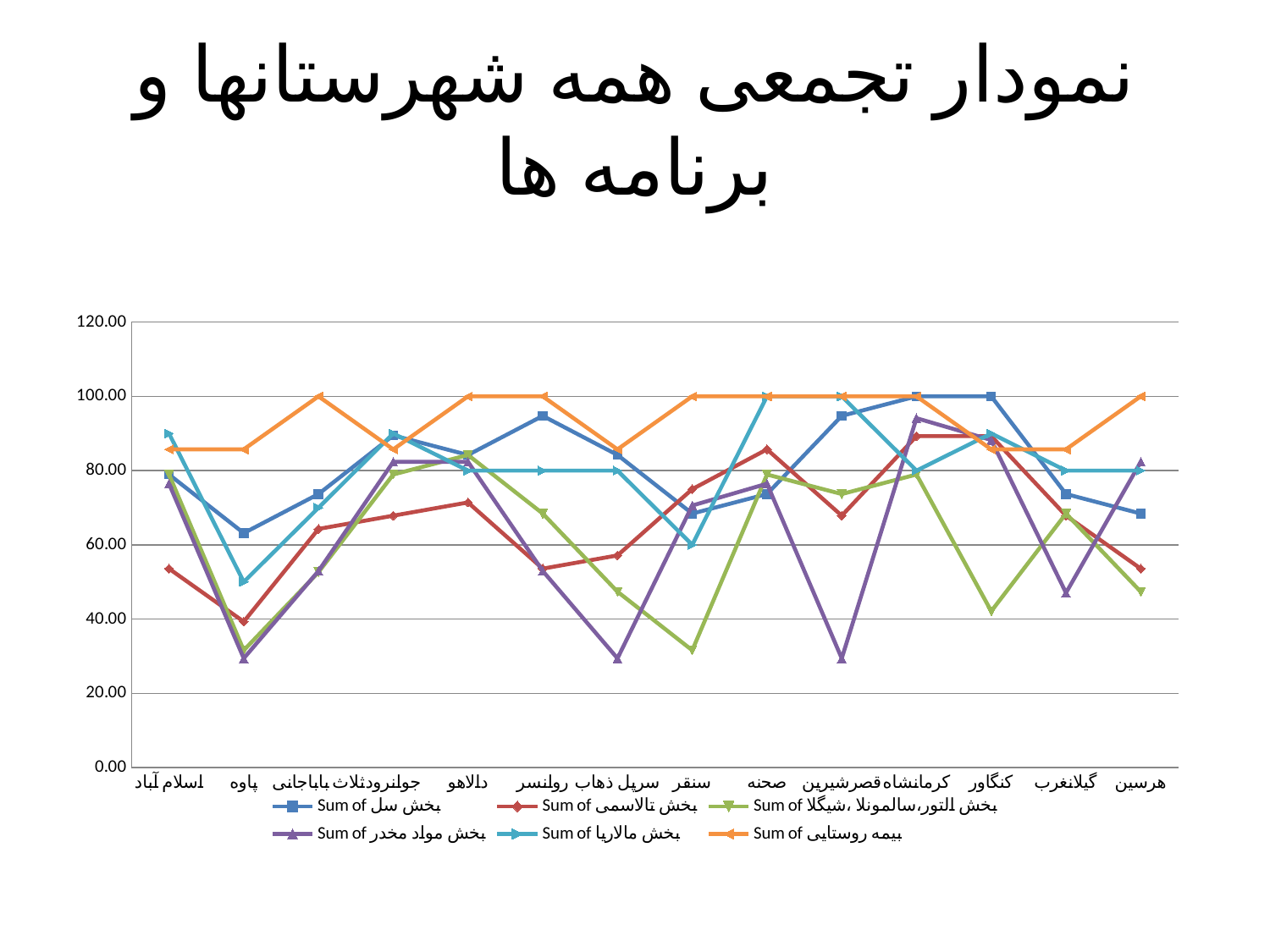
Which series has the highest value for هرسین? Sum of بیمه روستایی Is the value of Sum of بخش سل for روانسر greater or less than 80? greater How many categories are shown along the x axis? 14 Is the value of Sum of بخش مالاریا for صحنه greater or less than 80? greater What kind of chart is shown on the slide? line chart Is the value of Sum of بخش تالاسمی for اسلام آباد greater or less than 60? less What is the title of the chart? نمودار تجمعی همه شهرستانها و برنامه ها How many series does the legend list? 6 For پاوه, which is larger: Sum of بخش سل or Sum of Sum of بخش مولد مخدر? Sum of بخش سل Which series is drawn in orange? Sum of بیمه روستایی